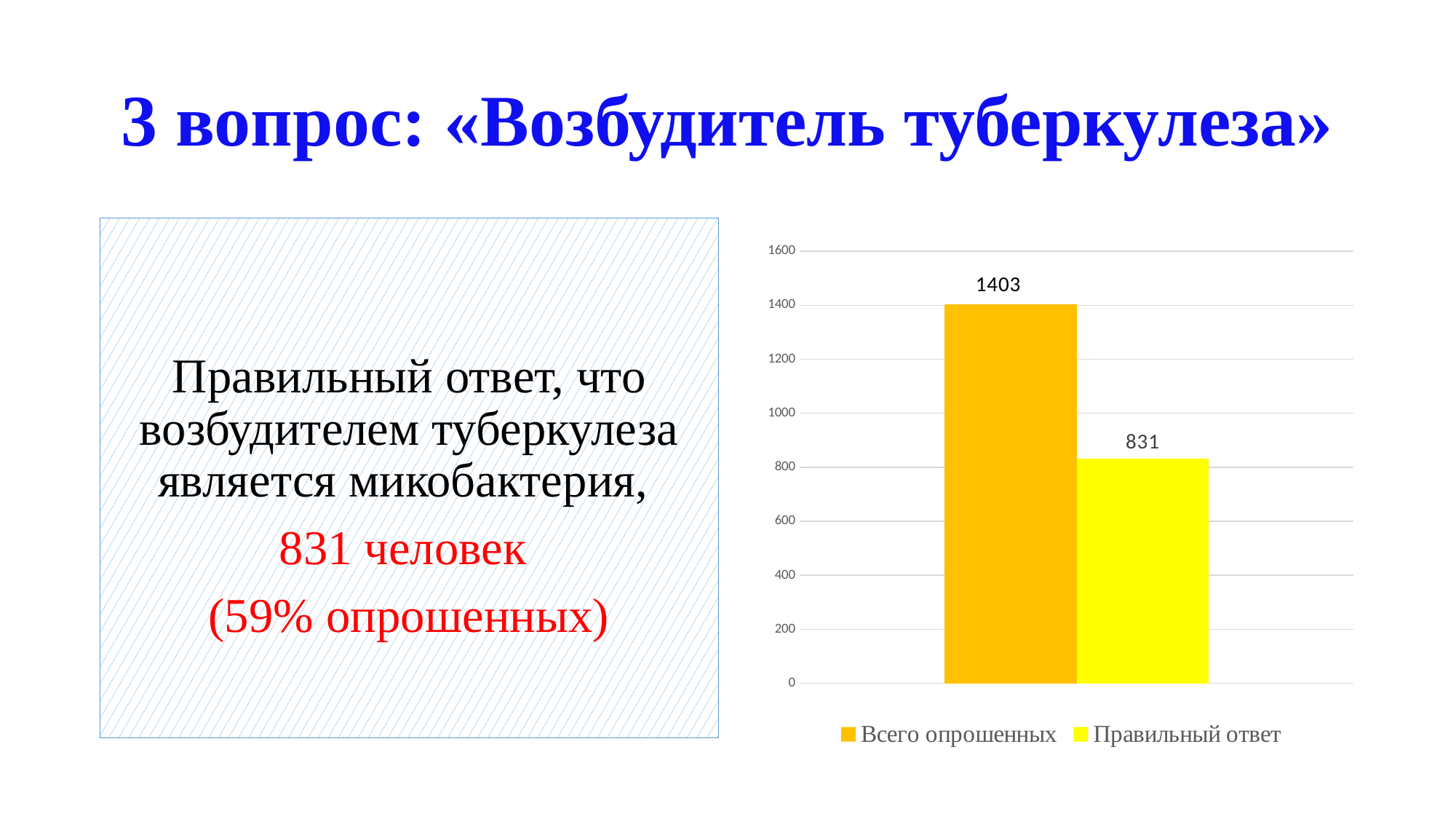
Is the value for Всего опрошенных greater or less than 1200? greater Which is larger, Всего опрошенных or Правильный ответ? Всего опрошенных What kind of chart is shown on the slide? bar chart How many series does the legend list? 2 Which series has the lowest value? Правильный ответ What is the difference between Всего опрошенных and Правильный ответ? 572 Which series has the highest value? Всего опрошенных How many bars are plotted in the chart? 2 What is the value for Правильный ответ? 831 Is the value for Правильный ответ greater or less than 1000? less What colour is the bar for Правильный ответ? yellow What is the value for Всего опрошенных? 1403